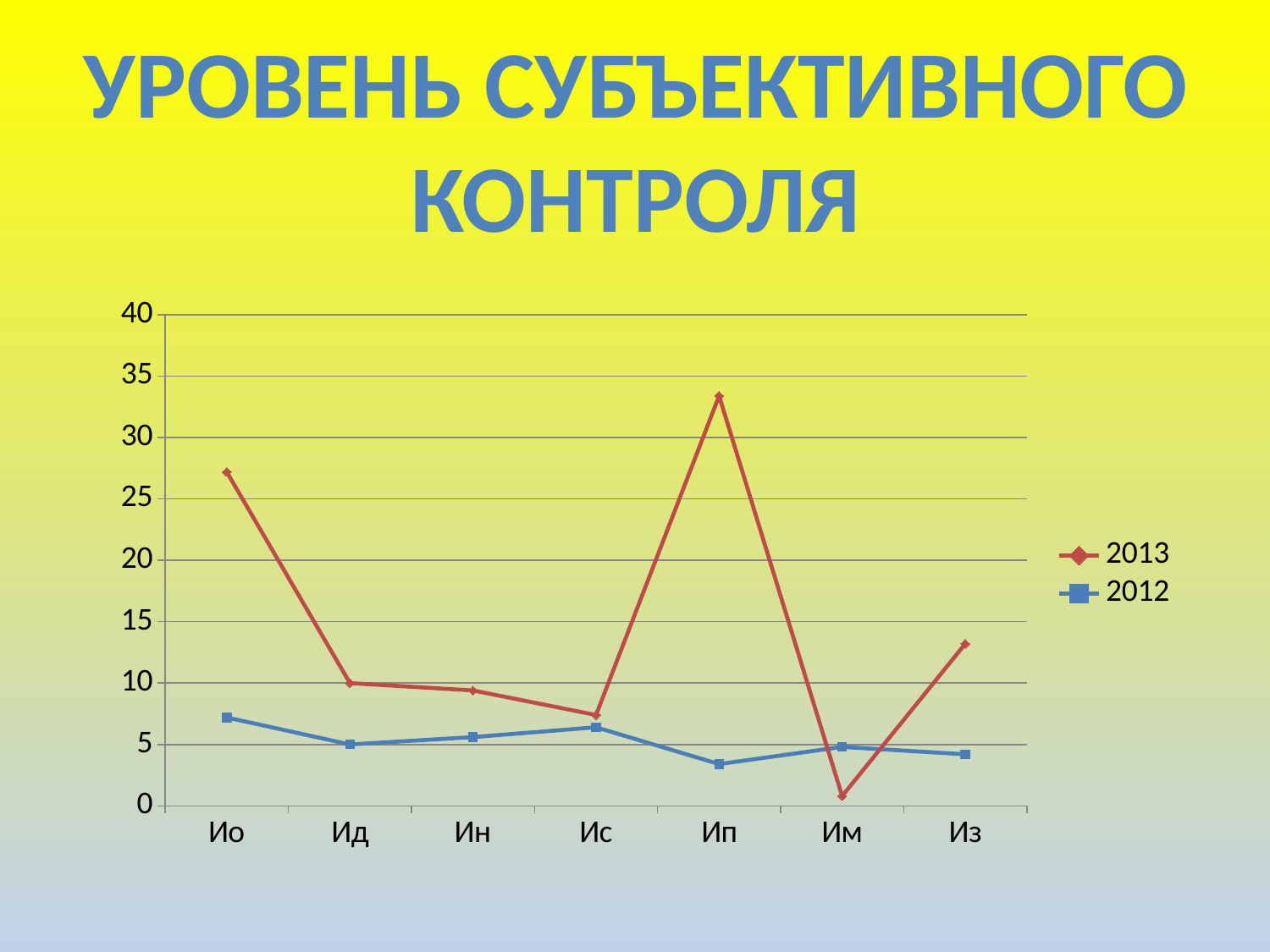
For the 2013 series, which category has the highest value? Ип For the 2013 series, which category has the lowest value? Им Which series has the larger value for Ио, 2013 or 2012? 2013 How many series does the legend list? 2 Is the 2013 value for Ип greater or less than 30? greater What is the title of the slide? УРОВЕНЬ СУБЪЕКТИВНОГО КОНТРОЛЯ How many categories are shown on the x axis? 7 Is the 2012 value for Ип greater or less than 5? less What kind of chart is shown on the slide? line chart Which series has the larger value for Им, 2013 or 2012? 2012 For the 2012 series, which category has the highest value? Ио Is the 2013 value for Ио greater or less than 25? greater